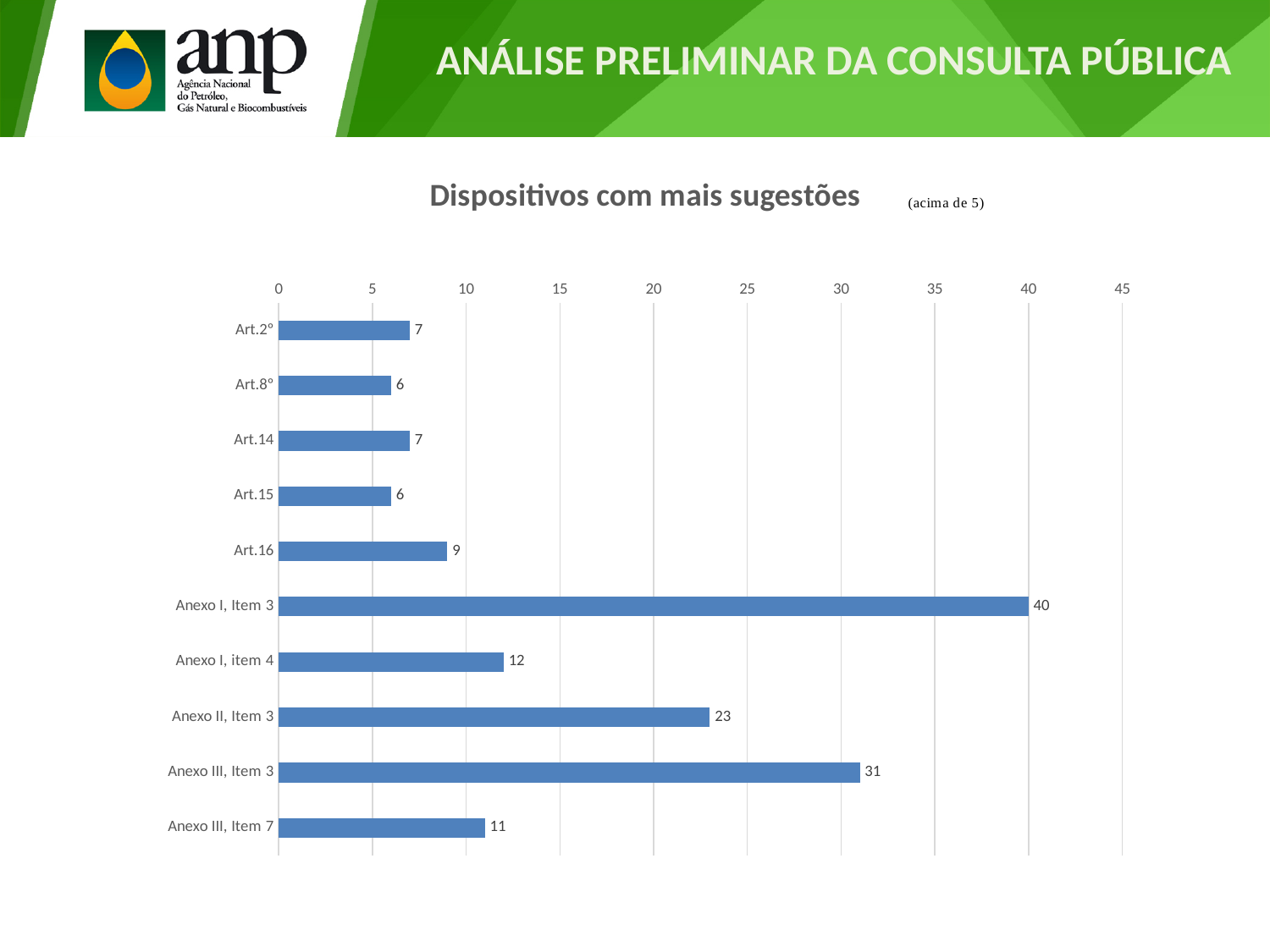
What is the value for Art.16? 9 Which is larger, the value for Anexo I, item 4 or the value for Anexo III, Item 7? Anexo I, item 4 What is the title of the chart? Dispositivos com mais sugestões What is the difference between the values for Anexo III, Item 3 and Anexo II, Item 3? 8 What is the value for Art.8°? 6 How many categories are shown in the chart? 10 What is the difference between the values for Anexo I, Item 3 and Art.2°? 33 Which category has the highest value? Anexo I, Item 3 Is the value for Anexo II, Item 3 greater or less than 20? greater What is the value for Anexo III, Item 7? 11 What kind of chart is shown on the slide? bar chart What is the value for Anexo I, Item 3? 40